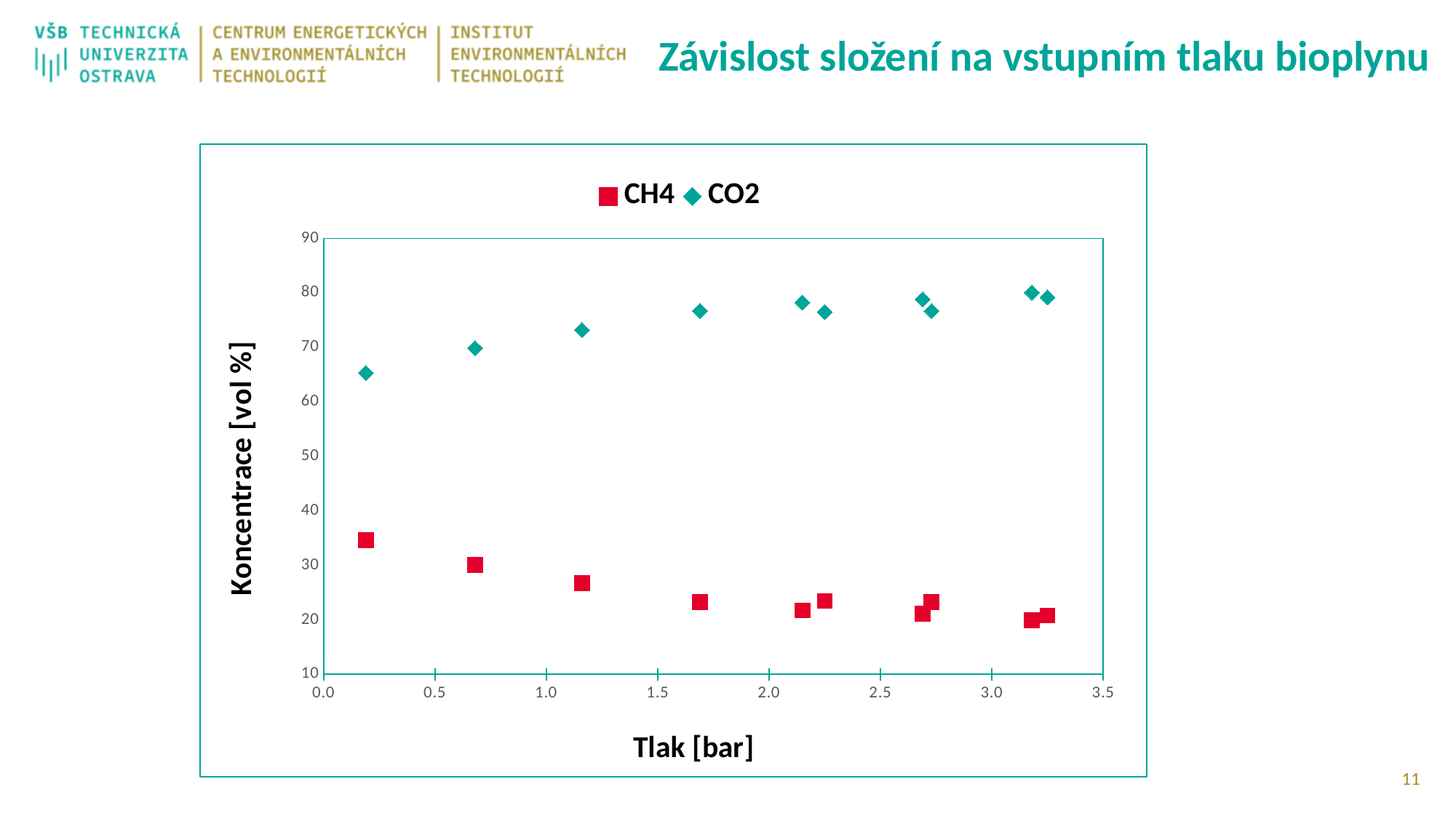
Which two series are listed in the legend? CH4 and CO2 How many series does the legend list? 2 Is the CH4 value at the lowest pressure (around 0.2 bar) greater or less than 30? greater How many CH4 data points are plotted? 10 Does the CO2 concentration rise or fall as the pressure increases along the x axis? rise Is the CH4 value at the highest pressure (around 3.2 bar) greater or less than 30? less Does the CH4 concentration rise or fall as the pressure increases along the x axis? fall What kind of chart is shown on the slide? scatter chart Is the CO2 value at the lowest pressure (around 0.2 bar) greater or less than 60? greater What is the title of the x axis? Tlak [bar] Which series has the higher concentration at around 1.7 bar, CH4 or CO2? CO2